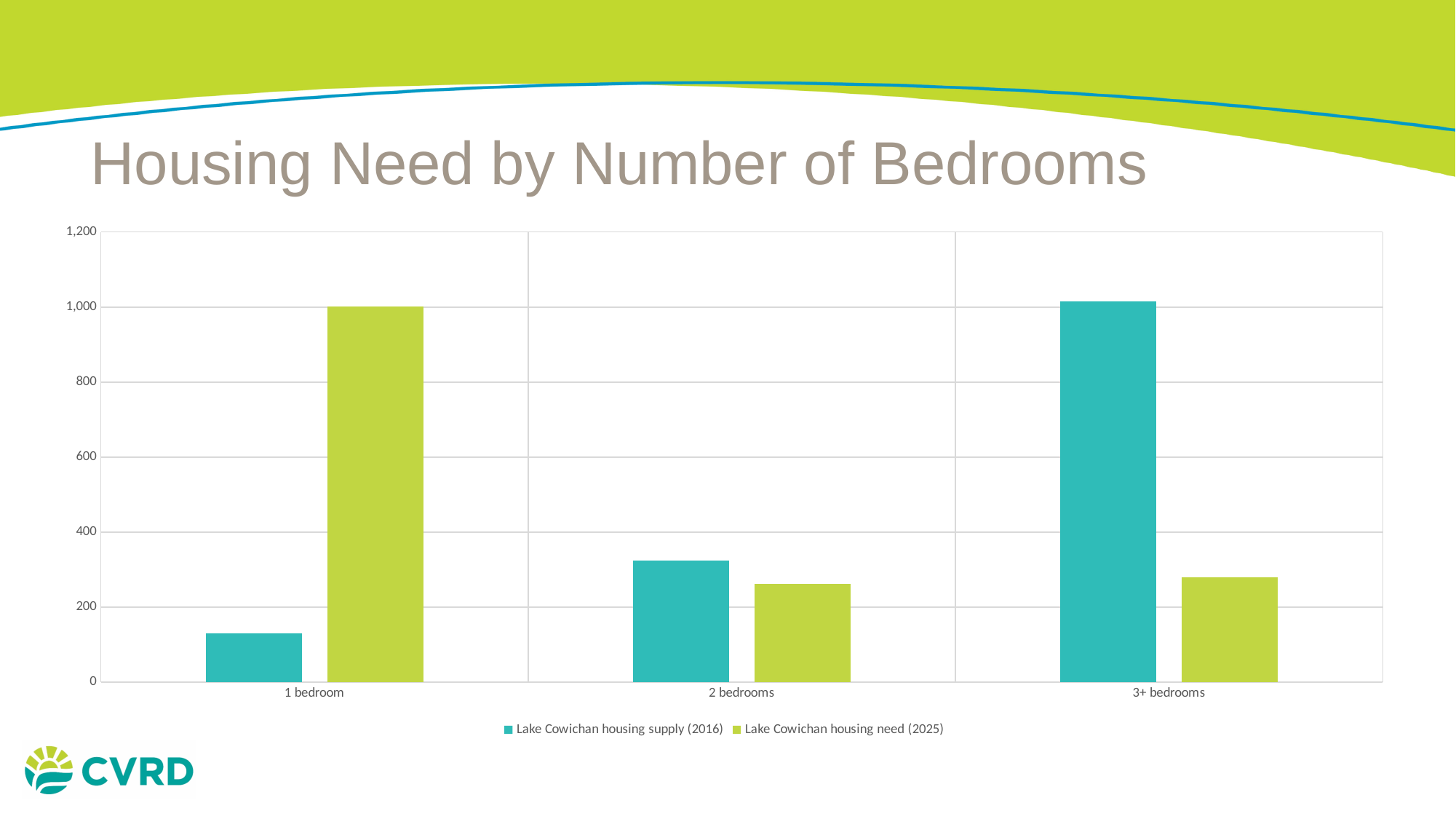
For 3+ bedrooms, which is larger: housing supply (2016) or housing need (2025)? Housing supply (2016) Is the Lake Cowichan housing supply (2016) for 1 bedroom greater or less than 200? less How many bedroom categories are shown on the x axis? 3 Which bedroom category has the lowest Lake Cowichan housing supply (2016)? 1 bedroom Is the Lake Cowichan housing need (2025) for 3+ bedrooms greater or less than 400? less Is the Lake Cowichan housing supply (2016) for 3+ bedrooms greater or less than 800? greater Which bedroom category has the highest Lake Cowichan housing supply (2016)? 3+ bedrooms Which bedroom category has the highest Lake Cowichan housing need (2025)? 1 bedroom What kind of chart is shown on the slide? Bar chart For 1 bedroom, which is larger: housing supply (2016) or housing need (2025)? Housing need (2025) How many series does the legend list? 2 Which colour represents Lake Cowichan housing need (2025) in the legend? Green